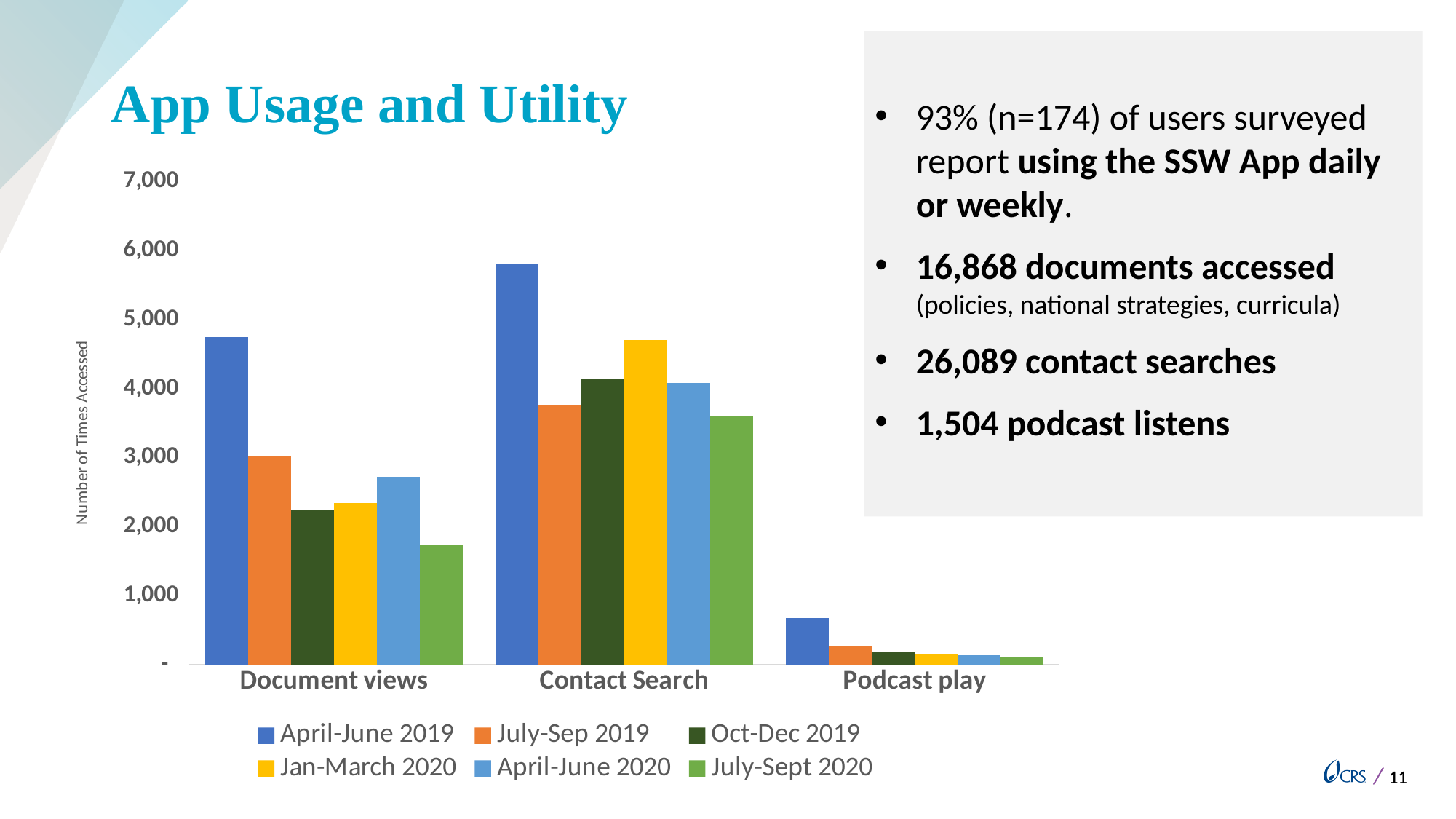
How many series does the chart's legend list? 6 Which series has the highest value in the Contact Search category? April-June 2019 Is the value for July-Sept 2020 in Document views greater or less than 2,000? less What kind of chart is shown on the slide? Bar chart How many categories are shown on the x axis of the chart? 3 Is the value for April-June 2019 in Contact Search greater or less than 5,000? greater Which series has the lowest value in the Document views category? July-Sept 2020 What is the label on the chart's vertical axis? Number of Times Accessed Which category has the lowest values overall across all series? Podcast play Is the value for April-June 2019 in Podcast play greater or less than 1,000? less Which is larger for April-June 2019: Document views or Contact Search? Contact Search